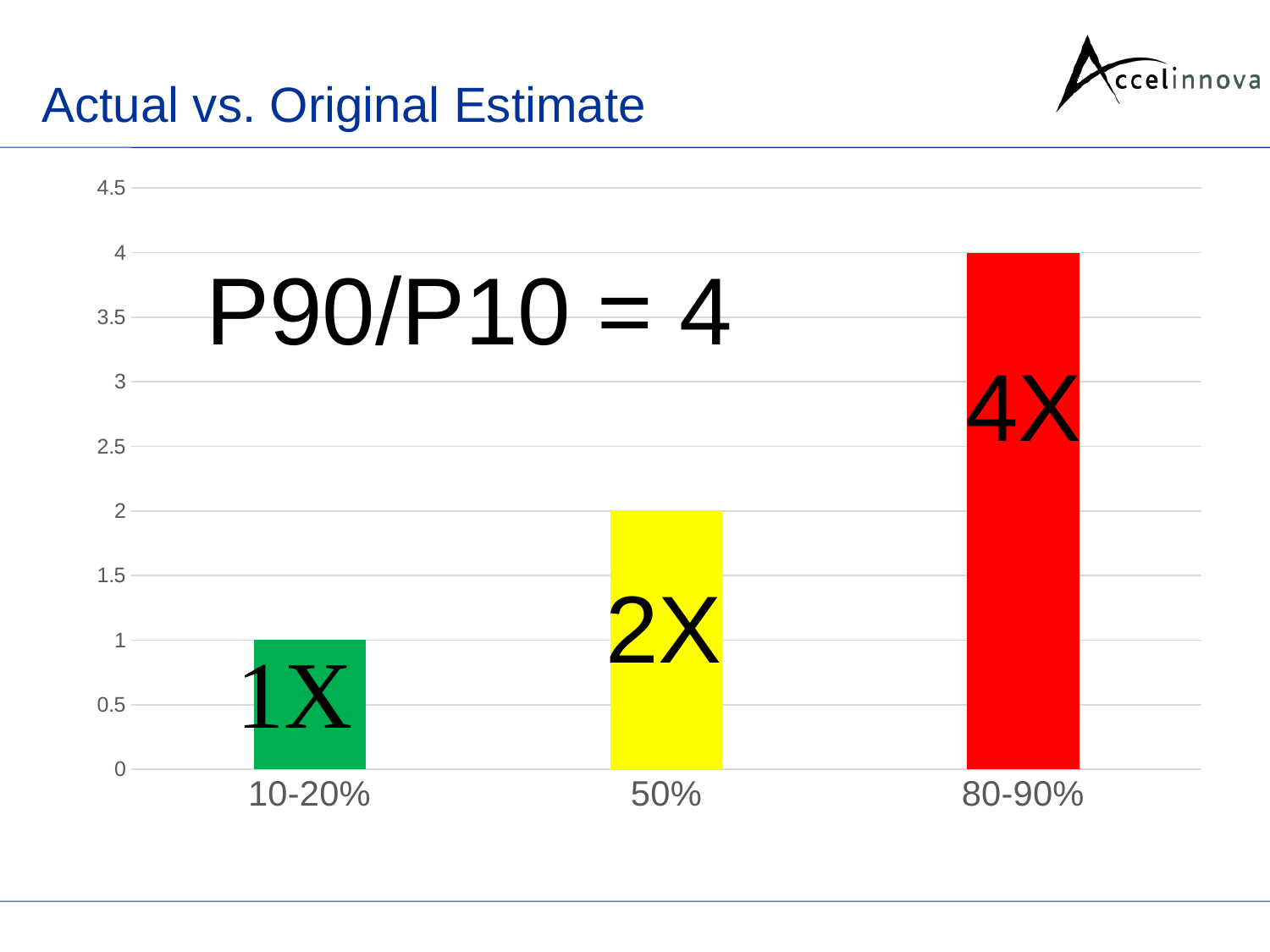
What label is printed on the bar for the 10-20% category? 1X What is the title of the slide's chart? Actual vs. Original Estimate Is the value for 80-90% greater or less than 3? greater Which category has the lowest bar? 10-20% Which bar is taller, the one for 50% or the one for 10-20%? 50% What label is printed on the bar for the 50% category? 2X Which category has the highest bar? 80-90% What label is printed on the bar for the 80-90% category? 4X How many categories are shown on the x axis of the chart? 3 What colour is the bar for the 50% category? yellow What kind of chart is shown on the slide? bar chart Do the bar values rise or fall from left to right along the x axis? rise